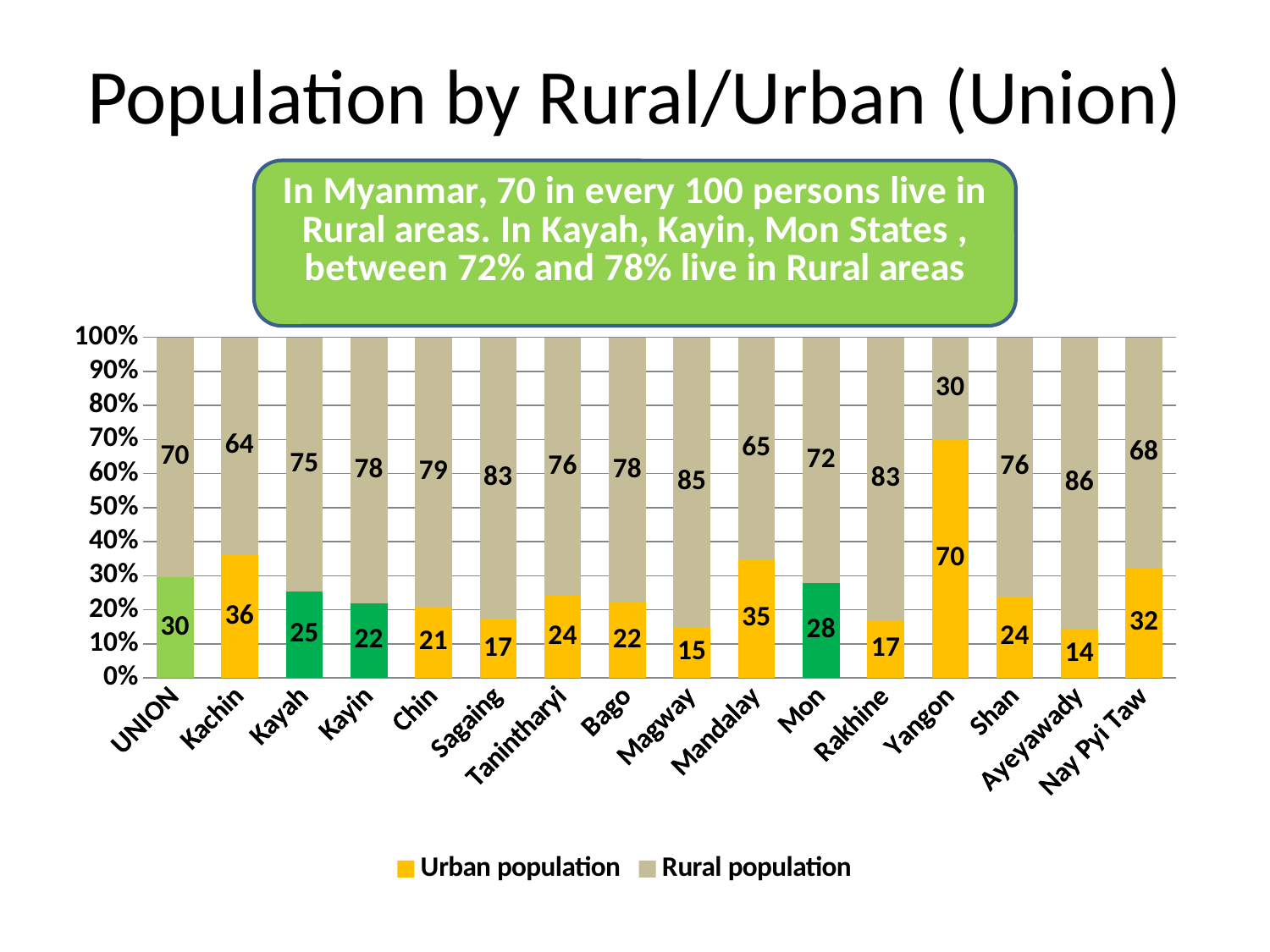
What is the difference between the Rural population values for Magway and Mandalay? 20 How many categories are shown on the x axis? 16 Which category has the highest Urban population value? Yangon What is the Urban population value for Yangon? 70 Which category has the lowest Urban population value? Ayeyawady Which is larger, the Urban population value for Mon or for Kayah? Mon What is the Urban population value for Kachin? 36 What kind of chart is shown on the slide? Stacked bar chart Which category has the lowest Rural population value? Yangon How many series does the legend list? 2 What is the title of the slide containing the chart? Population by Rural/Urban (Union) What is the Rural population value for Ayeyawady? 86